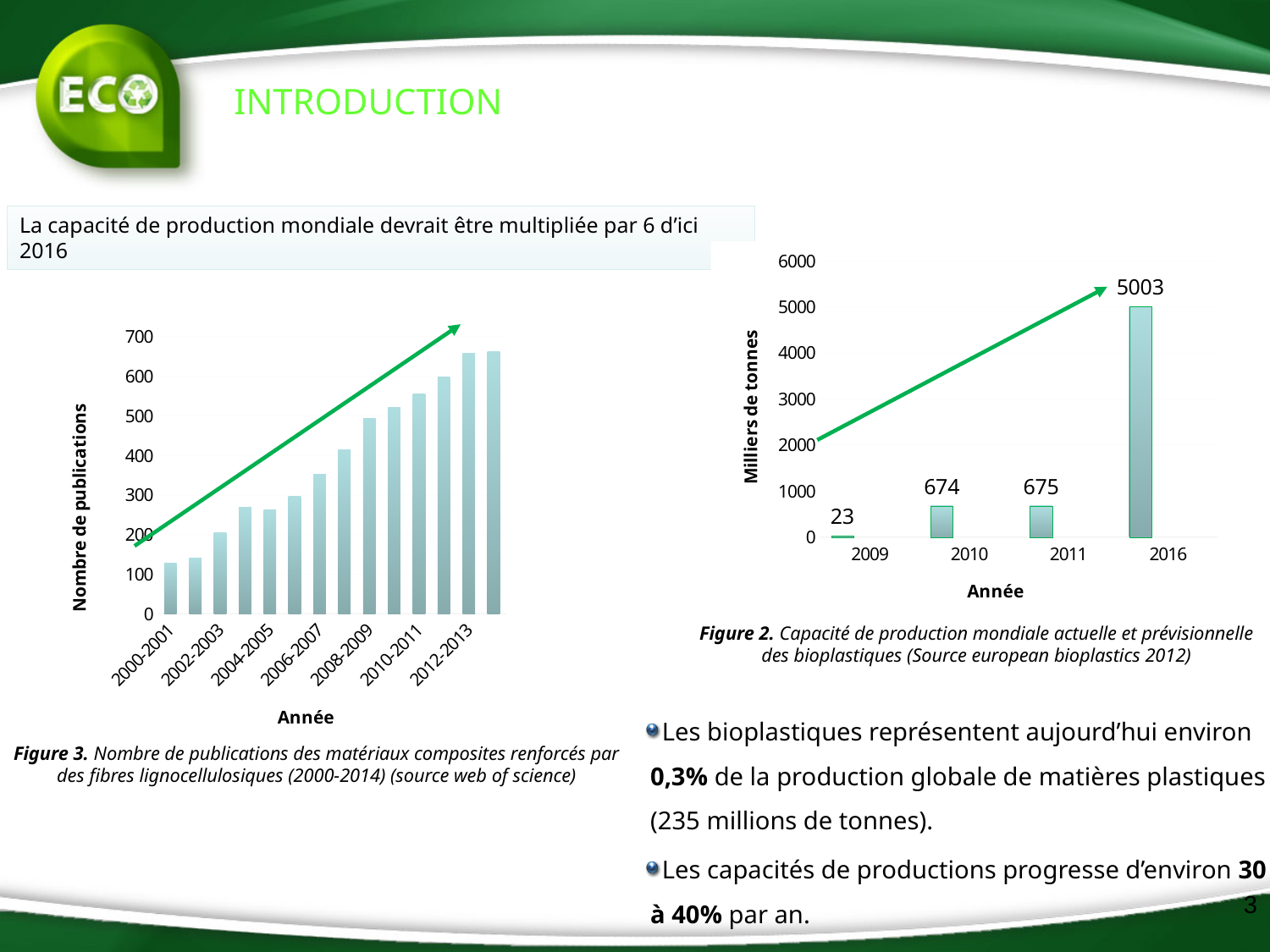
In Figure 3, is the value for 2012-2013 greater or less than 600? greater In Figure 2, which year has the lowest value? 2009 In Figure 2, what is the difference between the values for 2016 and 2009? 4980 In Figure 3, is the value for 2000-2001 greater or less than 200? less In Figure 2, what is the value for 2016? 5003 In Figure 2, which year has the highest value? 2016 In Figure 3, do the values generally rise or fall from 2000-2001 to 2012-2013? rise In Figure 2, how many years are shown on the x axis? 4 In Figure 2, what is the value for 2010? 674 What kind of chart is Figure 3? bar chart In Figure 2, what is the label of the y axis? Milliers de tonnes In Figure 2, what is the value for 2009? 23